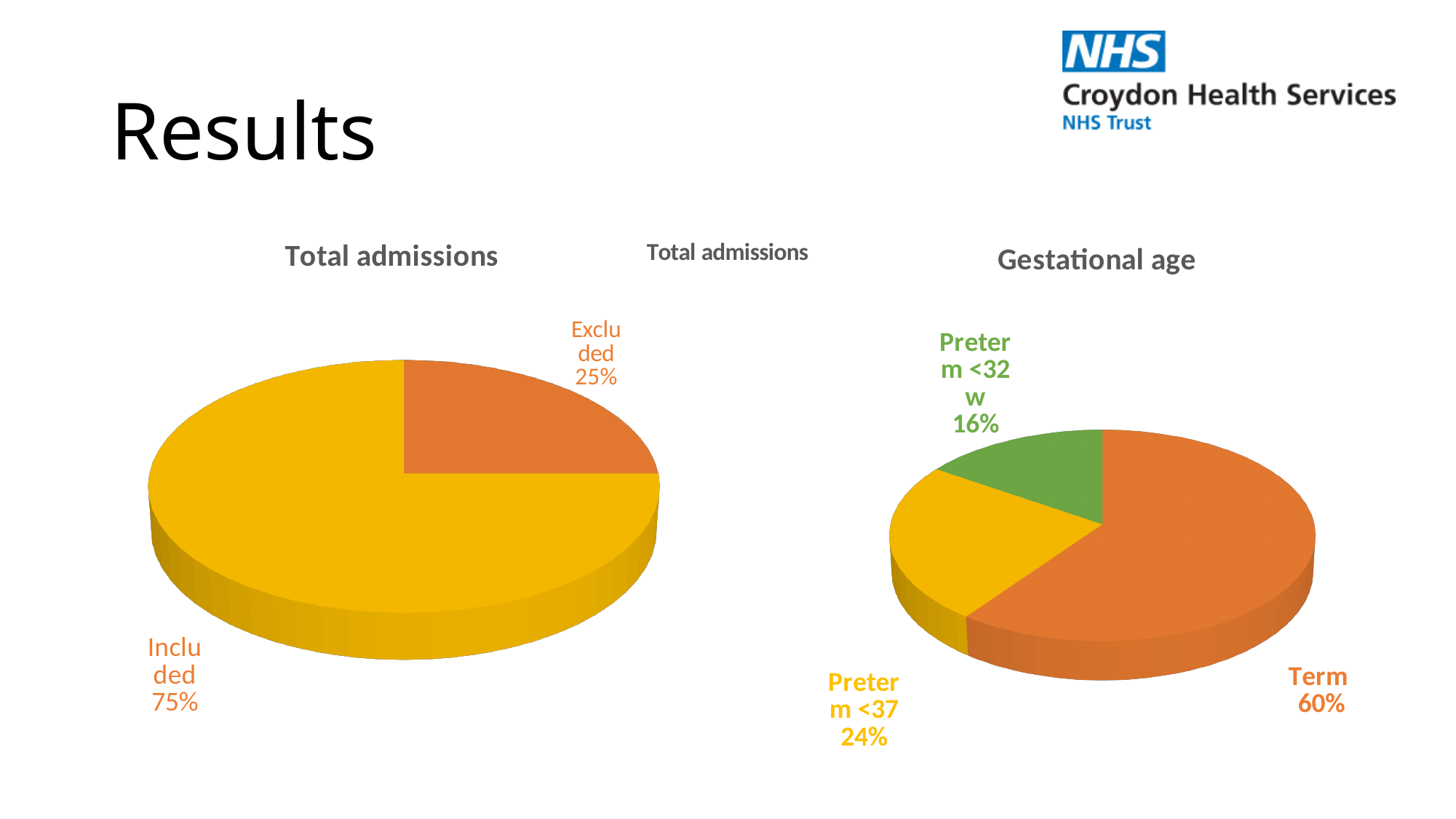
In the 'Gestational age' pie chart, what is the difference in percentage points between Term and Preterm <37? 36 In the 'Total admissions' pie chart, what share is labelled Excluded? 25% In the 'Gestational age' pie chart, how many slices are there? 3 In the 'Gestational age' pie chart, what share is labelled Preterm <37? 24% In the 'Gestational age' pie chart, which category has the smallest share? Preterm <32 w In the 'Total admissions' pie chart, how many slices are there? 2 In the 'Gestational age' pie chart, what share is labelled Term? 60% What kind of chart is the 'Total admissions' chart? Pie chart In the 'Total admissions' pie chart, which slice is larger, Included or Excluded? Included In the 'Gestational age' pie chart, which category has the largest share? Term